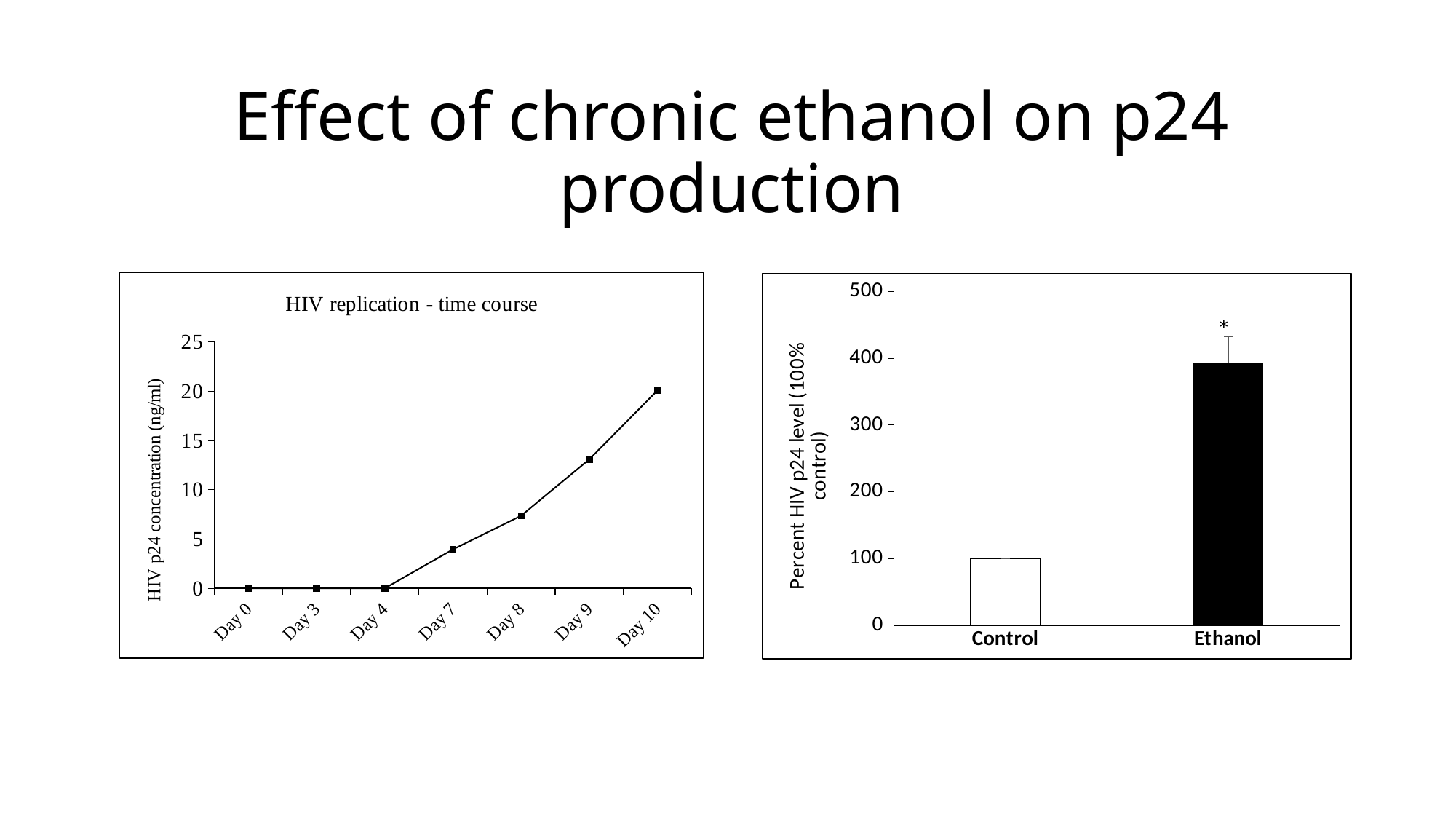
On the right chart, is the value for Ethanol greater or less than 300? greater On the left chart (HIV replication - time course), what is the HIV p24 concentration on Day 0? 0 What kind of chart is the left chart (HIV replication - time course)? line chart On the right chart, which bar is larger, Control or Ethanol? Ethanol On the left chart (HIV replication - time course), is the value for Day 7 greater or less than 5? less On the left chart (HIV replication - time course), how many data points are plotted? 7 On the left chart (HIV replication - time course), do the values rise or fall from Day 4 to Day 10? rise On the left chart (HIV replication - time course), is the value for Day 9 greater or less than 10? greater What kind of chart is the right chart? bar chart On the left chart (HIV replication - time course), which day has the highest HIV p24 concentration? Day 10